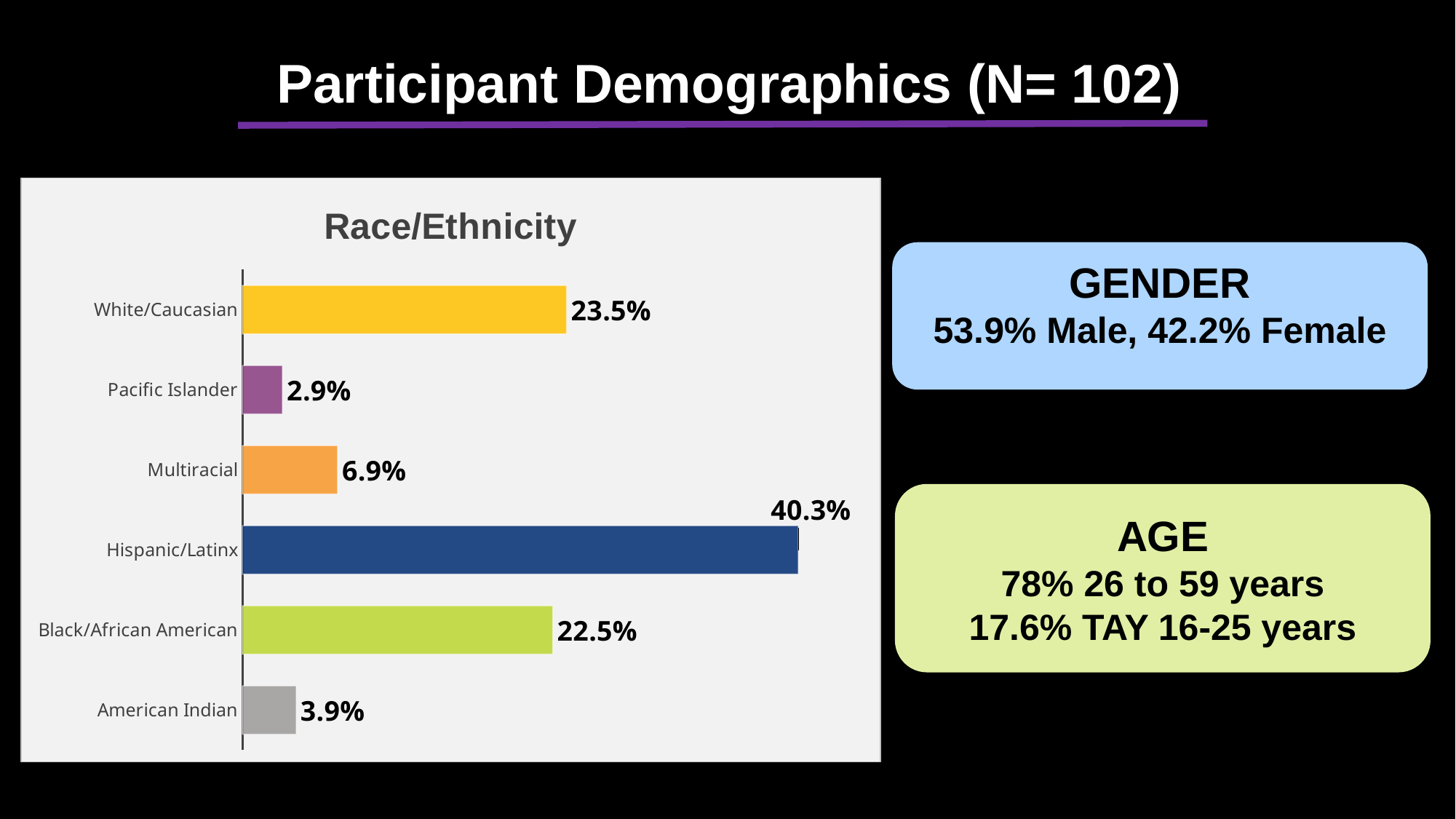
What is the value for Pacific Islander in the Race/Ethnicity chart? 2.9% What is the value for White/Caucasian in the Race/Ethnicity chart? 23.5% What is the title of the chart on the slide? Race/Ethnicity Which category has the highest value in the Race/Ethnicity chart? Hispanic/Latinx Which category has the lowest value in the Race/Ethnicity chart? Pacific Islander What is the difference between the Hispanic/Latinx and White/Caucasian values in the Race/Ethnicity chart? 16.8% What is the value for Black/African American in the Race/Ethnicity chart? 22.5% Which is larger in the Race/Ethnicity chart, Multiracial or American Indian? Multiracial What kind of chart is the Race/Ethnicity chart? Bar chart What is the difference between the Multiracial and American Indian values in the Race/Ethnicity chart? 3.0% What is the value for Hispanic/Latinx in the Race/Ethnicity chart? 40.3% How many categories are shown in the Race/Ethnicity chart? 6